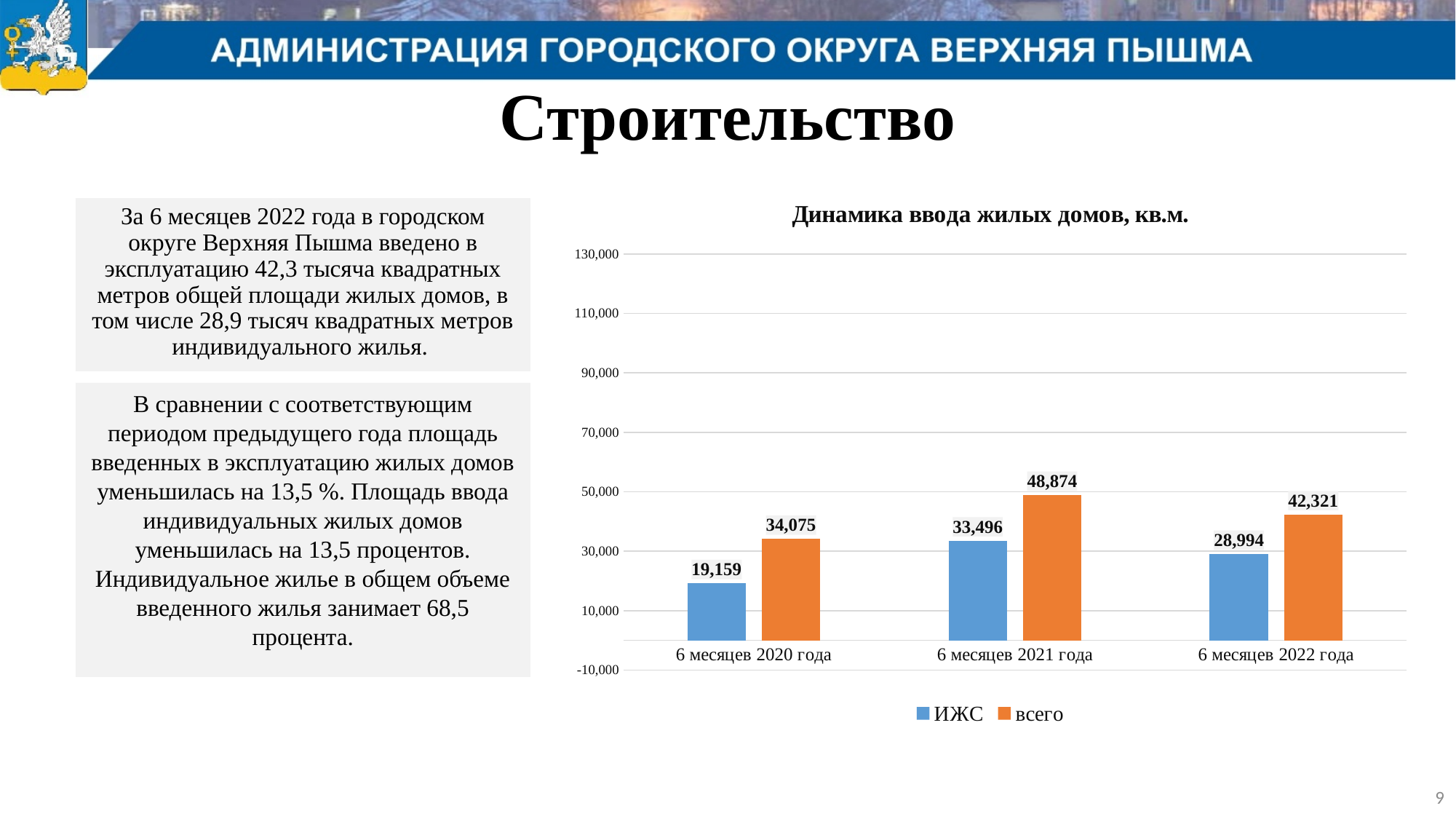
Which is larger: ИЖС for 6 месяцев 2021 года or ИЖС for 6 месяцев 2022 года? ИЖС for 6 месяцев 2021 года What is the value of ИЖС for 6 месяцев 2022 года? 28,994 What is the value of всего for 6 месяцев 2022 года? 42,321 What is the value of всего for 6 месяцев 2021 года? 48,874 In which period is the всего value highest? 6 месяцев 2021 года What is the value of ИЖС for 6 месяцев 2020 года? 19,159 What type of chart is shown? bar chart How many periods are shown on the x axis? 3 In which period is the ИЖС value lowest? 6 месяцев 2020 года How many series does the legend list? 2 Is the value of всего for 6 месяцев 2020 года greater or less than 30,000? greater What is the difference between всего and ИЖС for 6 месяцев 2022 года? 13,327